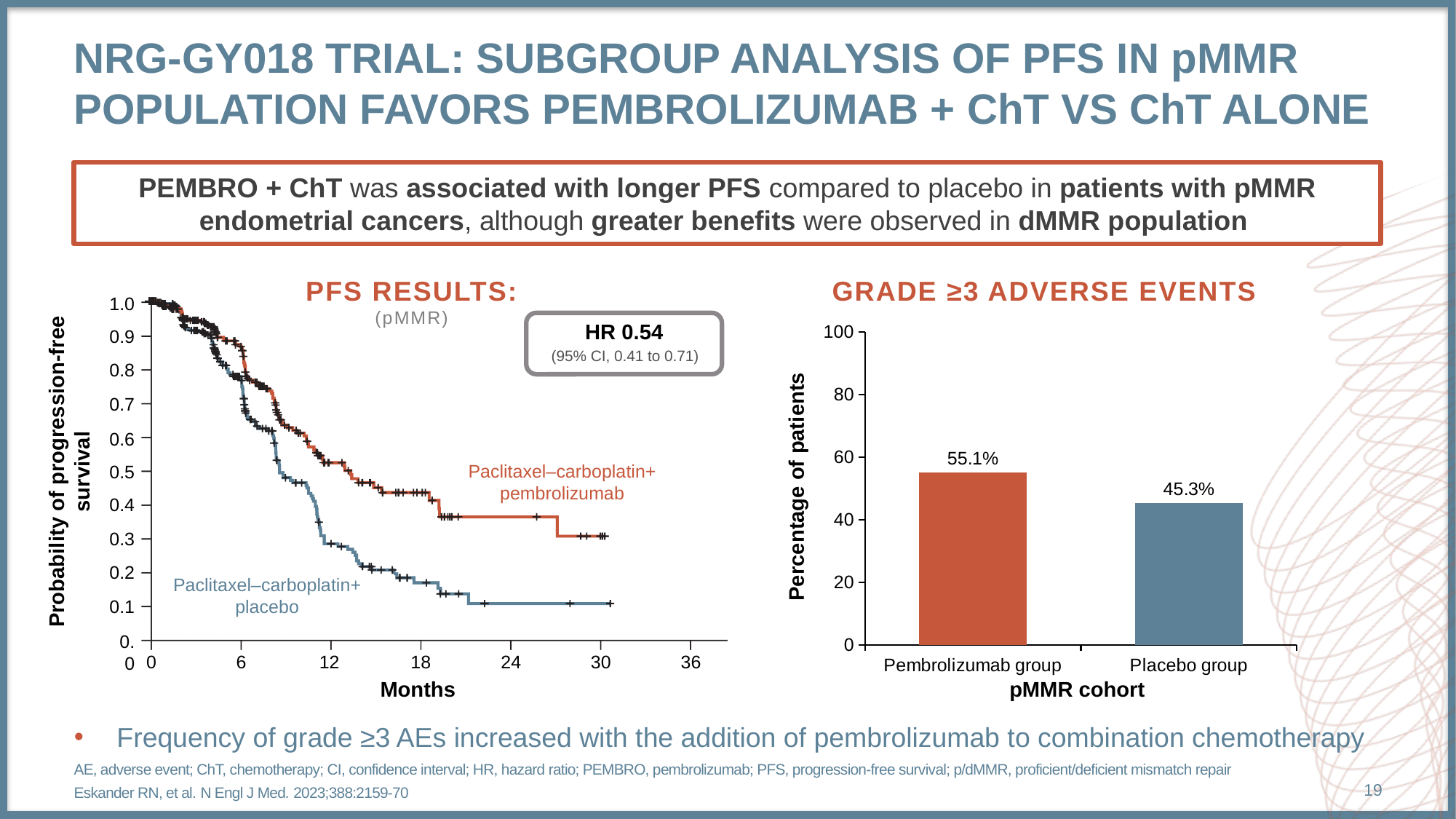
In the Grade ≥3 Adverse Events chart, what is the percentage of patients for the Pembrolizumab group? 55.1% In the Grade ≥3 Adverse Events chart, which group has the higher percentage of patients? Pembrolizumab group What kind of chart is the Grade ≥3 Adverse Events chart? Bar chart In the Grade ≥3 Adverse Events chart, is the value for the Placebo group greater or less than 60? less In the PFS Results chart, at 24 months, which curve is higher: paclitaxel–carboplatin + pembrolizumab or paclitaxel–carboplatin + placebo? Paclitaxel–carboplatin + pembrolizumab In the Grade ≥3 Adverse Events chart, what is the difference in percentage points between the Pembrolizumab group and the Placebo group? 9.8% In the PFS Results chart, at 12 months, is the probability of progression-free survival for the placebo arm greater or less than 0.5? less In the Grade ≥3 Adverse Events chart, how many groups are plotted? 2 In the PFS Results chart, what hazard ratio is shown in the box? HR 0.54 In the PFS Results chart, how many treatment arms are plotted? 2 In the PFS Results chart, do the survival curves rise or fall as months increase? Fall In the Grade ≥3 Adverse Events chart, what is the percentage of patients for the Placebo group? 45.3%